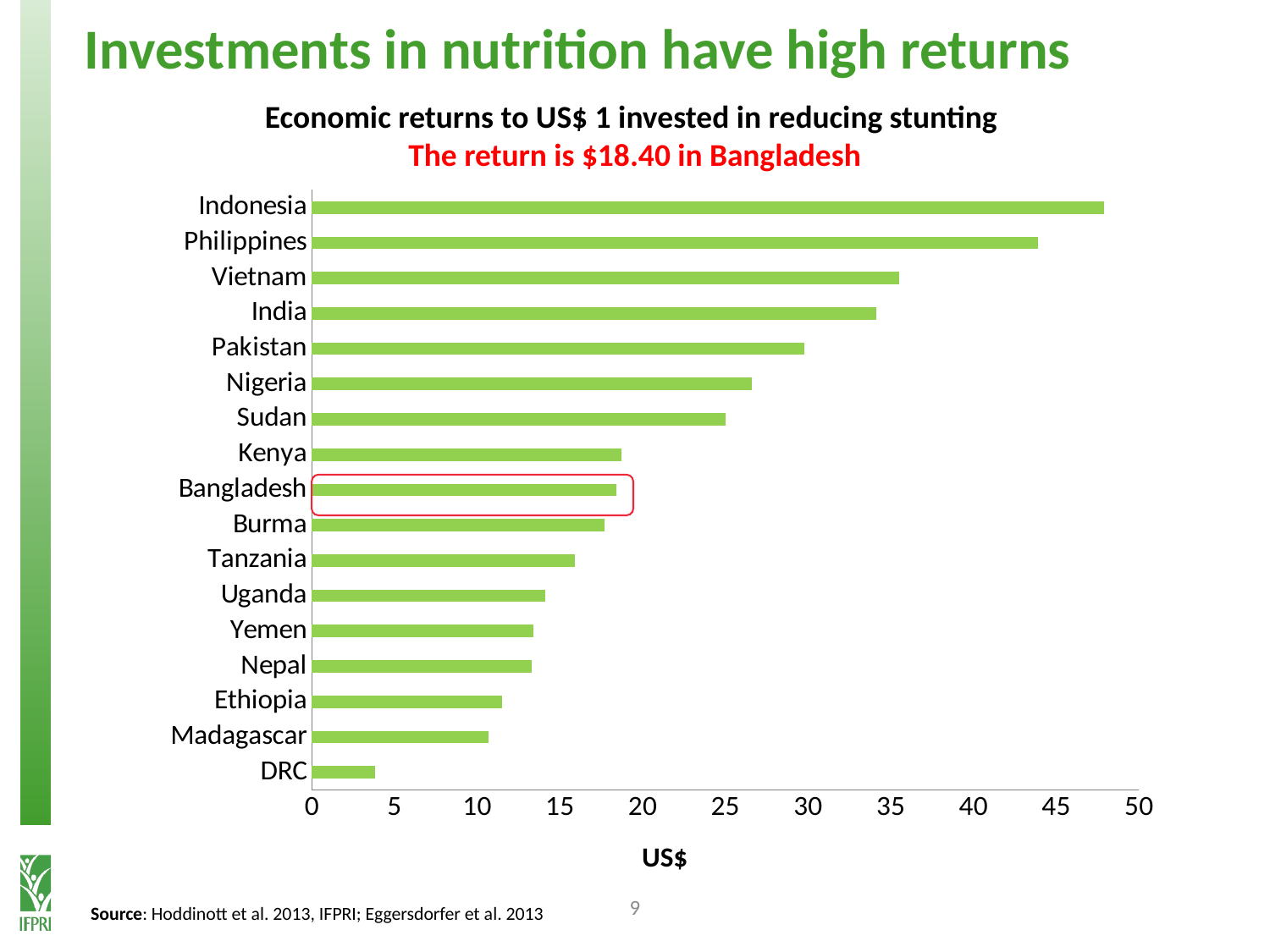
Is the value for DRC greater or less than 5? less How many countries are shown in the chart? 17 Which country has the highest economic return to US$ 1 invested in reducing stunting? Indonesia What kind of chart is used to show the economic returns? Bar chart Which country has the lowest economic return to US$ 1 invested in reducing stunting? DRC Is the value for Indonesia greater or less than 45? greater Which has a higher economic return, Tanzania or Uganda? Tanzania Which has a higher economic return, Indonesia or Philippines? Indonesia What is the economic return to US$ 1 invested in reducing stunting in Bangladesh? $18.40 What is the label on the horizontal axis of the chart? US$ Is the value for Philippines greater or less than 45? less